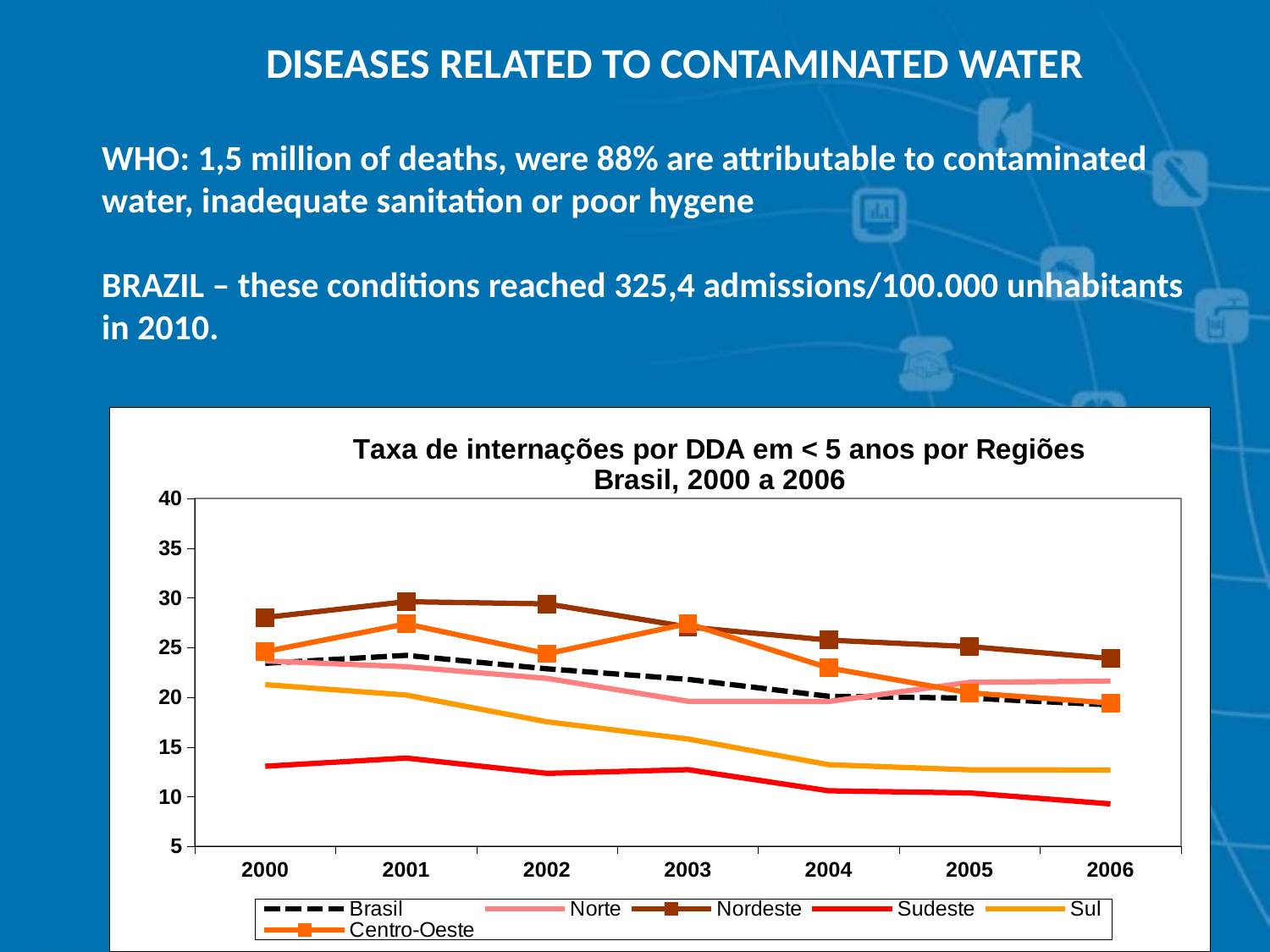
Does the Sul line rise or fall from 2000 to 2006? fall Is the value for Sudeste in 2000 greater or less than 15? less Is the value for Nordeste in 2001 greater or less than 25? greater What kind of chart is shown on the slide? line chart Which region has the lowest rate in 2006? Sudeste Does the Sudeste line rise or fall from 2000 to 2006? fall Which series is drawn as a dashed black line? Brasil Which region has the highest rate in 2000? Nordeste How many series does the legend list? 6 Is the value for Sudeste in 2006 greater or less than 10? less Which is higher in 2003, Nordeste or Sudeste? Nordeste How many years are shown along the x axis? 7